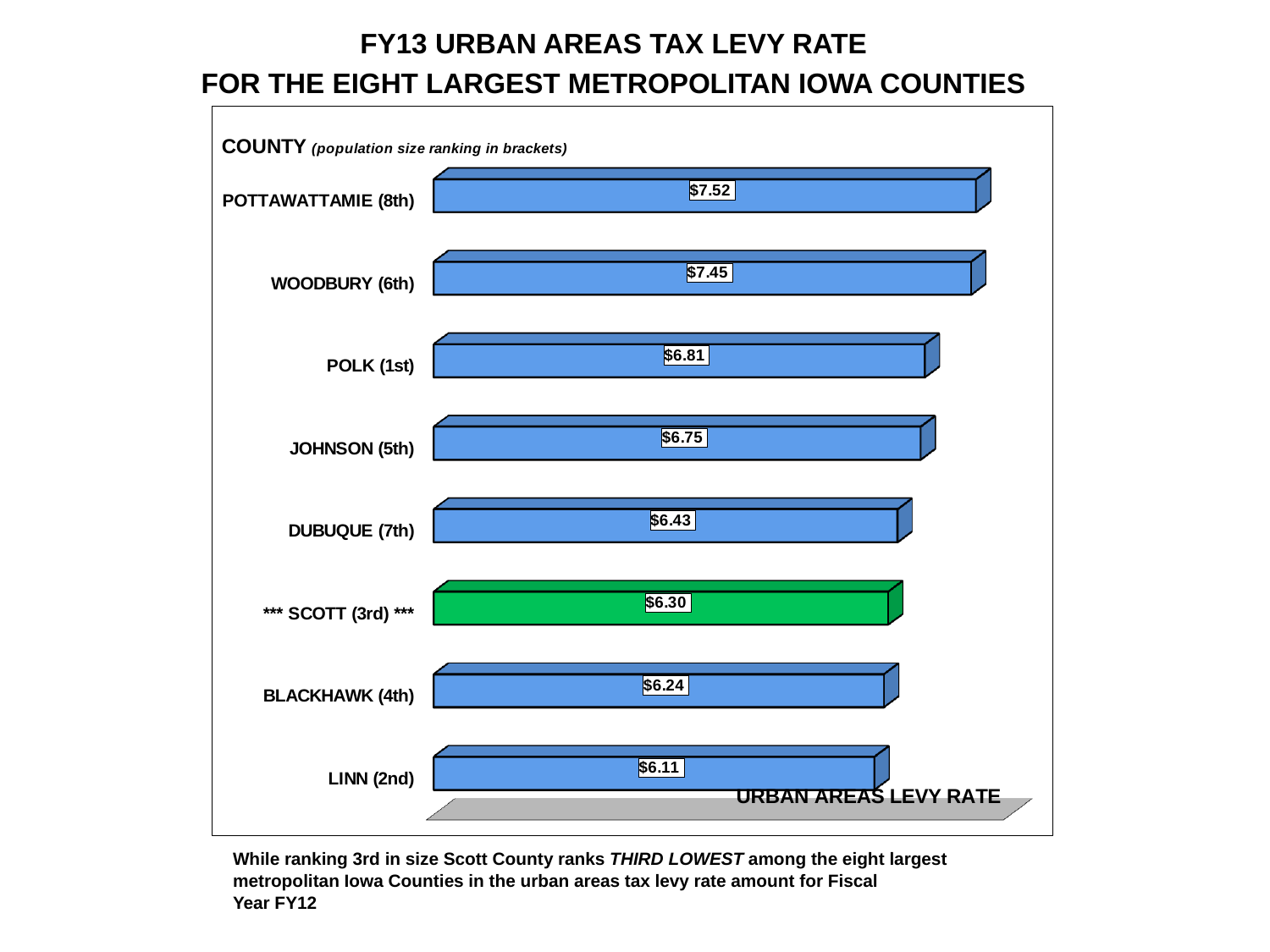
How many counties are shown in the chart? 8 What is the urban areas tax levy rate for Scott County? $6.30 Which has a higher levy rate, Dubuque or Blackhawk? Dubuque What is the urban areas tax levy rate for Linn County? $6.11 What is the population size ranking shown in brackets for Woodbury County? 6th What is the difference between the levy rates of Polk and Johnson counties? $0.06 What is the urban areas tax levy rate for Pottawattamie County? $7.52 Which county has the lowest urban areas tax levy rate? Linn (2nd) Which county's bar is coloured green instead of blue? Scott (3rd) Which county has the highest urban areas tax levy rate? Pottawattamie (8th) What kind of chart is shown on the slide? Bar chart What is the difference between the levy rates of Pottawattamie and Linn counties? $1.41